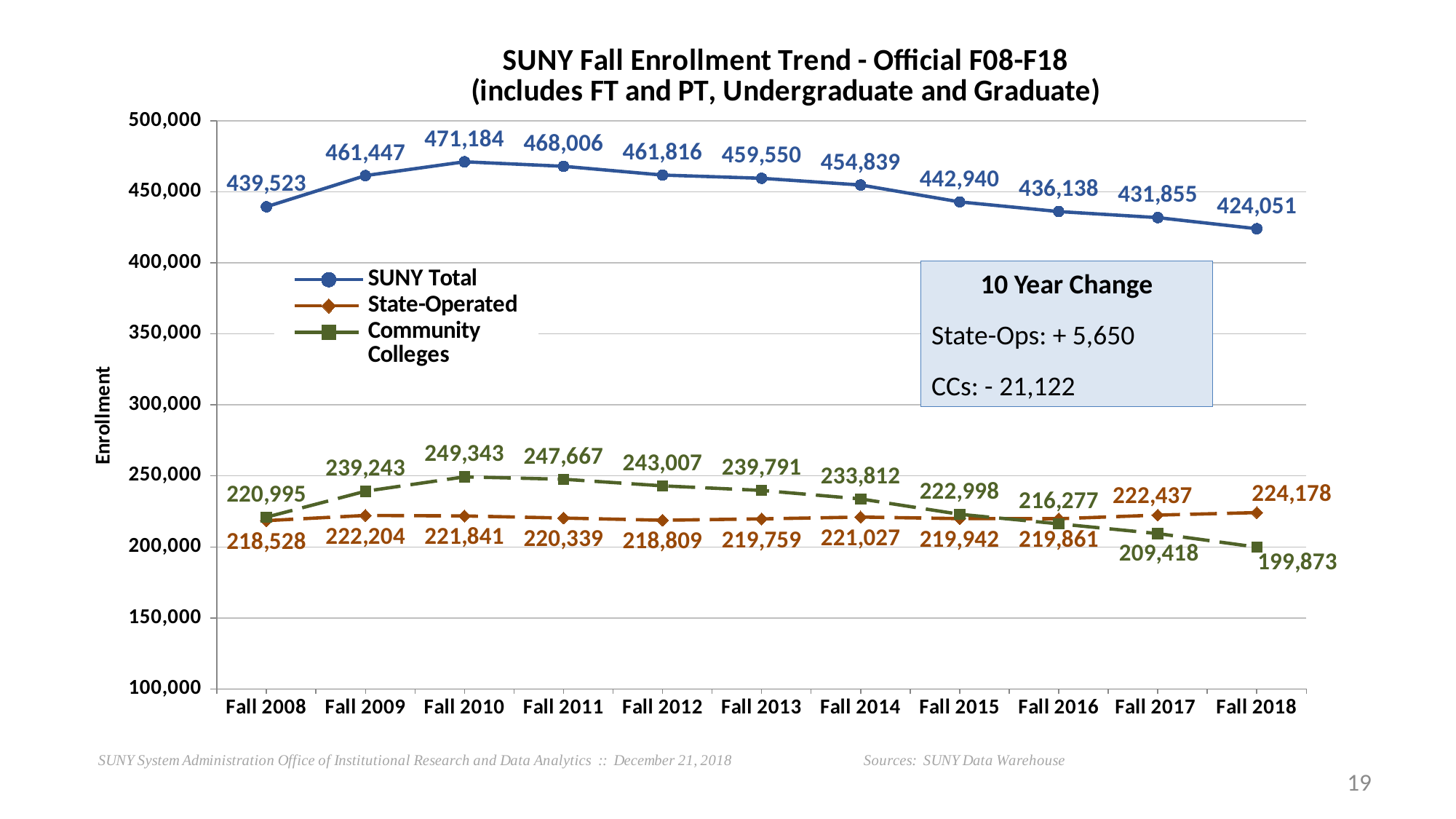
What is the title of the y axis? Enrollment What is the difference between the Community Colleges enrollment in Fall 2010 and Fall 2018? 49,470 What is the difference between the SUNY Total enrollment in Fall 2008 and Fall 2018? 15,472 What is the State-Operated enrollment for Fall 2018? 224,178 Does the SUNY Total enrollment rise or fall from Fall 2010 to Fall 2018? Fall How many fall terms are plotted on the x axis? 11 How many series does the legend list? 3 What kind of chart is shown on the slide? Line chart What is the SUNY Total enrollment for Fall 2010? 471,184 In Fall 2018, which is larger: State-Operated enrollment or Community Colleges enrollment? State-Operated In which fall term is the SUNY Total enrollment highest? Fall 2010 In which fall term is the Community Colleges enrollment lowest? Fall 2018